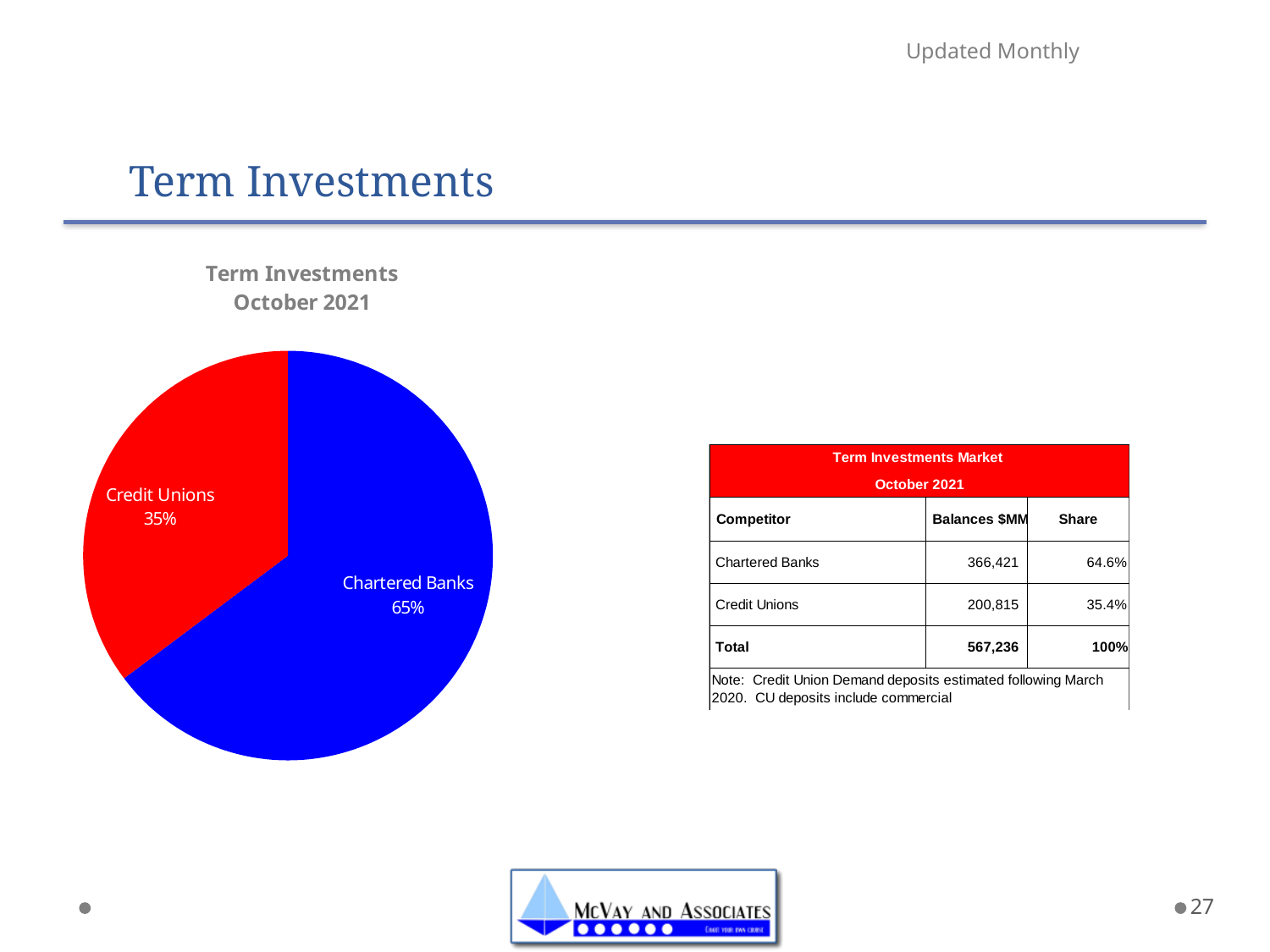
Is the share for Chartered Banks greater or less than 50%? greater What type of chart is shown on the slide? pie chart What is the difference in percentage points between the Chartered Banks slice and the Credit Unions slice? 30 What share of the pie does Chartered Banks hold? 65% How many slices does the pie chart have? 2 What share of the pie does Credit Unions hold? 35% Which category has the smallest slice of the pie? Credit Unions What is the title of the chart? Term Investments October 2021 What colour is the Credit Unions slice? red Which category has the largest slice of the pie? Chartered Banks Which is larger, the Credit Unions slice or the Chartered Banks slice? Chartered Banks